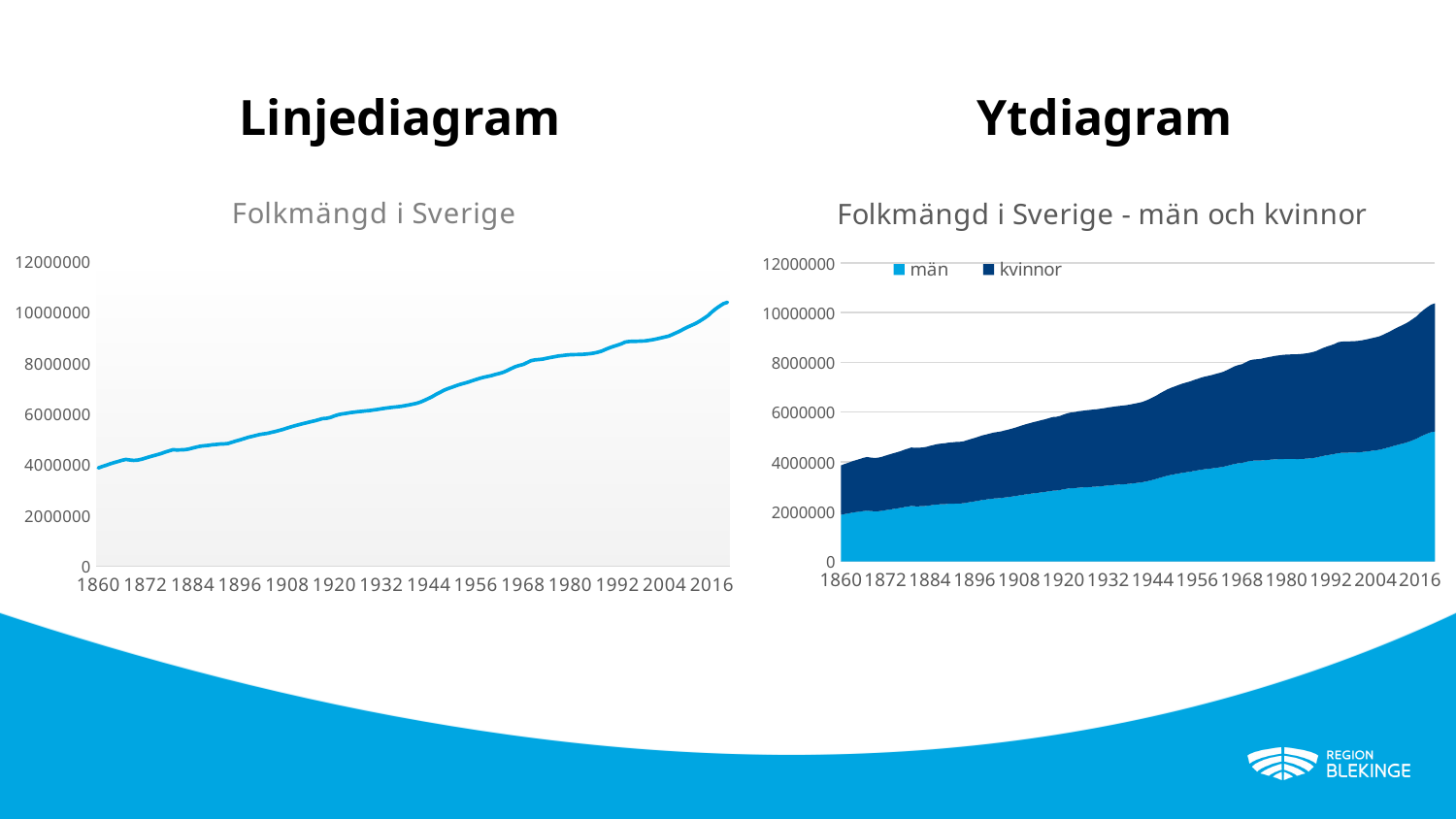
How many series does the legend of the right chart 'Folkmängd i Sverige - män och kvinnor' list? 2 In the right chart 'Folkmängd i Sverige - män och kvinnor', is the value for män in 1860 greater or less than 4000000? less In the left chart 'Folkmängd i Sverige', is the value for 1896 greater or less than 6000000? less In the left chart 'Folkmängd i Sverige', is the value for 1980 greater or less than 8000000? greater In the right chart 'Folkmängd i Sverige - män och kvinnor', does the total population rise or fall from 1860 to 2016? rise What kind of chart is the left chart titled 'Folkmängd i Sverige'? line chart What is the title of the left chart on the slide? Folkmängd i Sverige What kind of chart is the right chart titled 'Folkmängd i Sverige - män och kvinnor'? stacked area chart What are the two series named in the legend of the right chart 'Folkmängd i Sverige - män och kvinnor'? män and kvinnor In the left chart 'Folkmängd i Sverige', do the values rise or fall from 1860 to 2016? rise